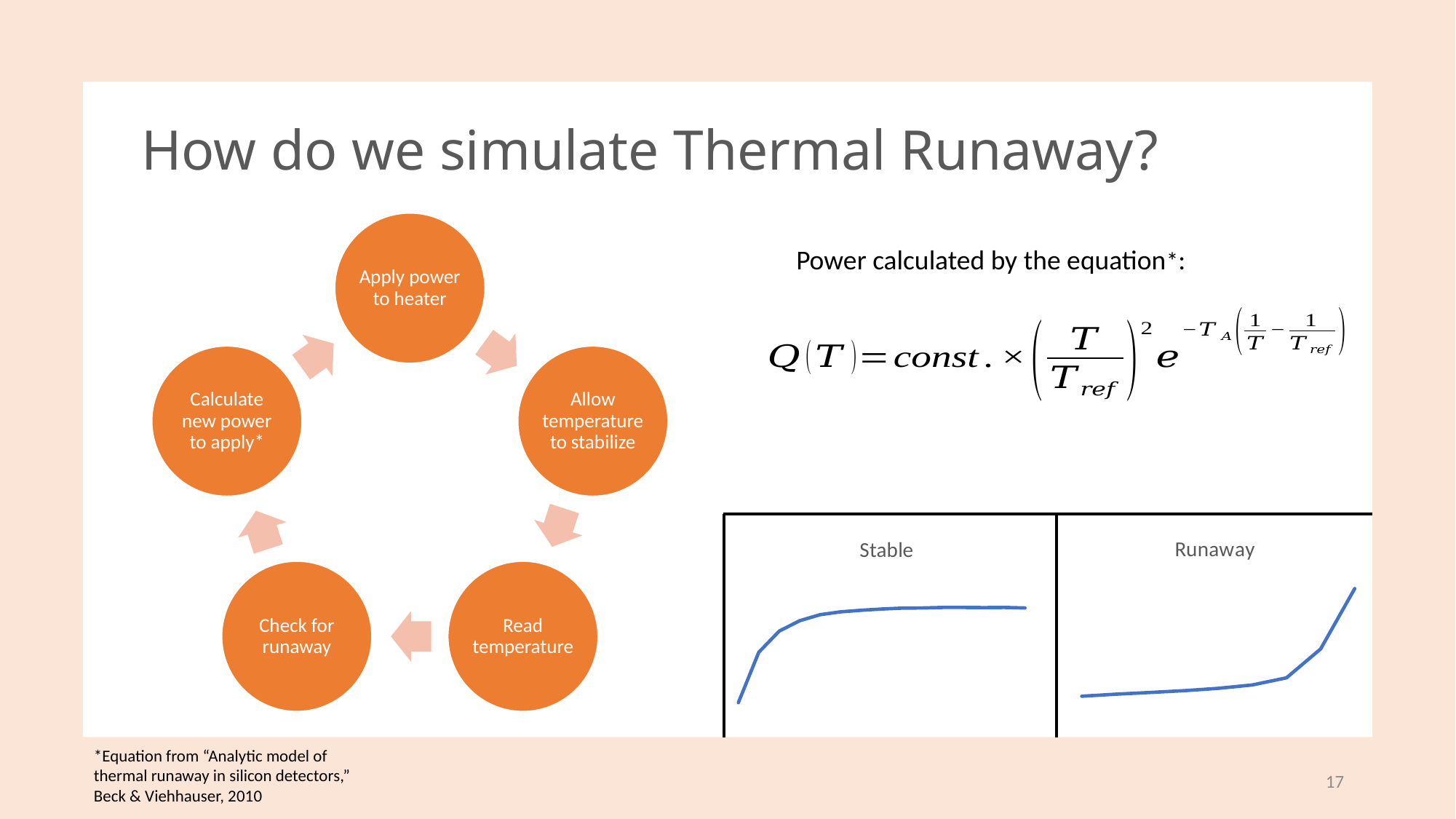
In the "Runaway" chart, does the line rise or fall along the x axis? rises, increasingly steeply How many lines are plotted in the "Stable" chart? 1 What kind of chart is the one titled "Stable"? line chart What colour is the plotted line in the "Runaway" chart? blue What kind of chart is the one titled "Runaway"? line chart How many charts are shown in the bottom-right panel of the slide? 2 In the "Runaway" chart, is the line steeper at the left end or the right end? right end What are the titles of the two charts in the bottom-right panel? Stable and Runaway In the "Stable" chart, does the line flatten out or keep climbing steeply toward the right? flattens out How many lines are plotted in the "Runaway" chart? 1